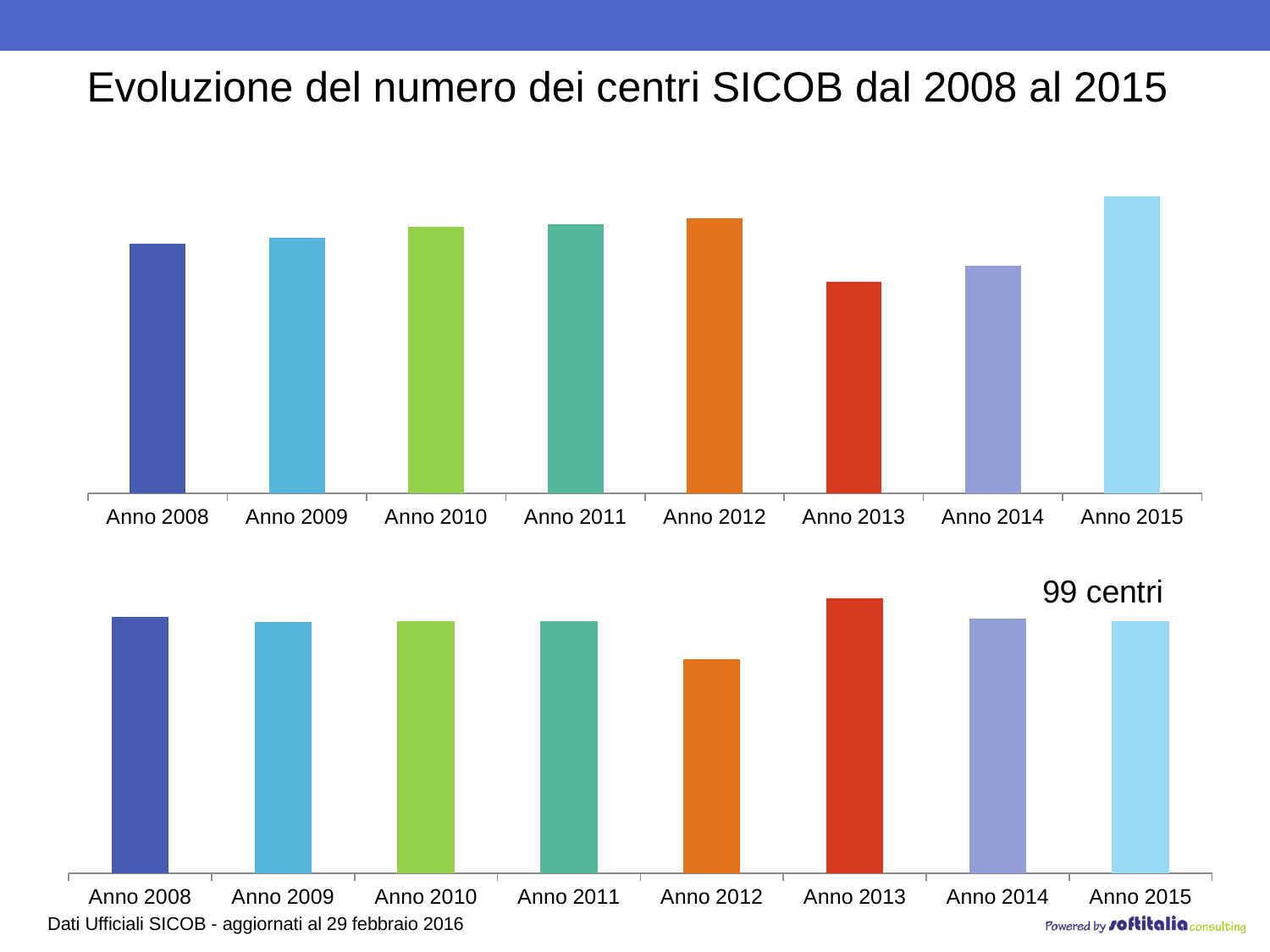
What kind of chart is the bottom chart on the slide? bar chart What is the title of the slide above the charts? Evoluzione del numero dei centri SICOB dal 2008 al 2015 In the top chart, do the bars rise or fall from Anno 2008 to Anno 2012? rise In the bottom chart, which year has the shortest bar? Anno 2012 In the bottom chart, which bar is taller: Anno 2012 or Anno 2013? Anno 2013 In the bottom chart, which year has the tallest bar? Anno 2013 In the top chart, which year has the tallest bar? Anno 2015 What kind of chart is the top chart on the slide? bar chart In the top chart, which year has the shortest bar? Anno 2013 In the bottom chart, how many bars are plotted? 8 In the top chart, which bar is taller: Anno 2012 or Anno 2013? Anno 2012 In the top chart, how many years are shown on the x axis? 8